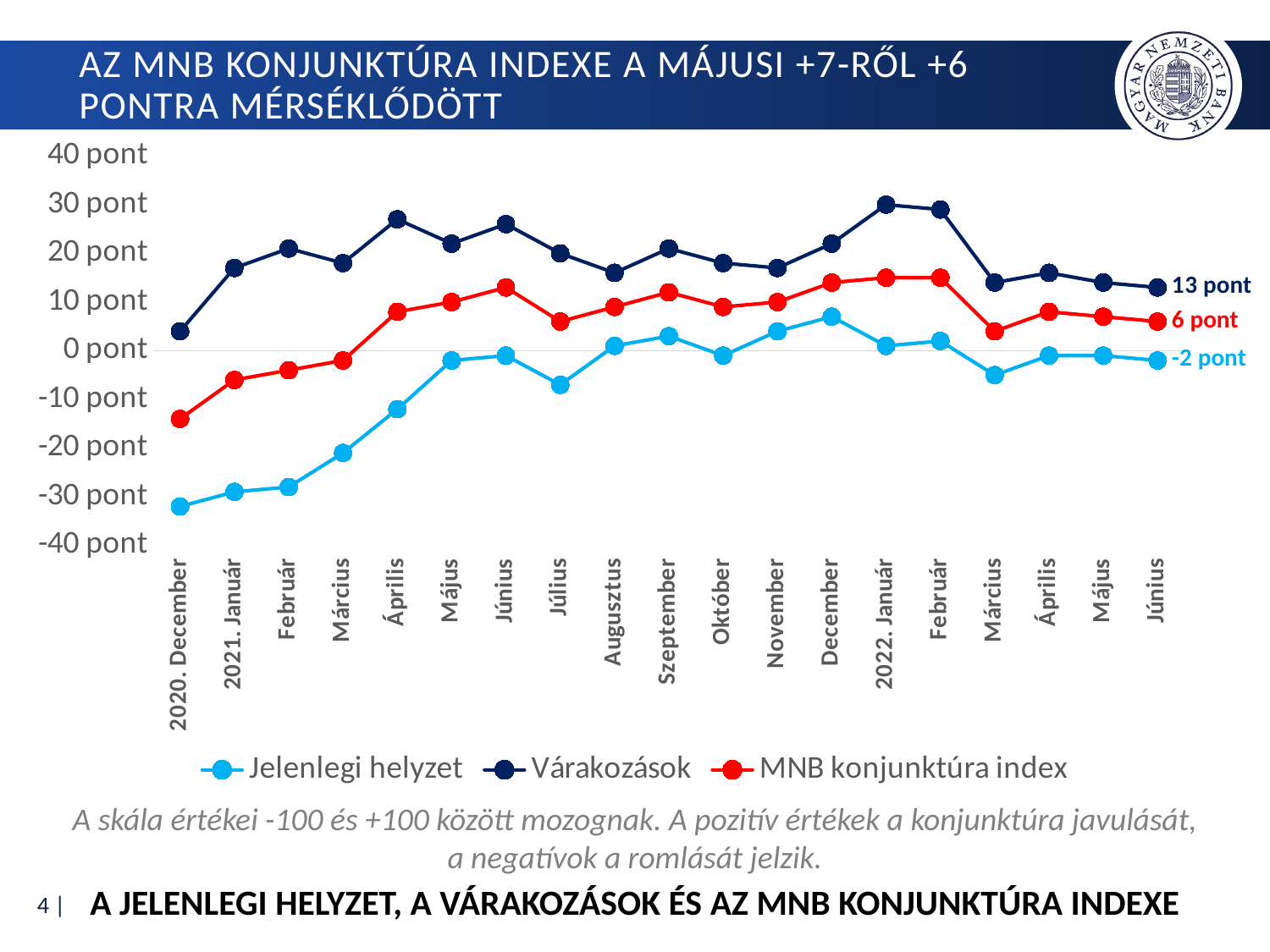
How many series does the legend list? 3 Is the value of Jelenlegi helyzet for 2020. December greater or less than -20 pont? less Which series has the highest value in 2022 Június? Várakozások What is the difference between the Várakozások and MNB konjunktúra index values in 2022 Június? 7 pont How many months are shown on the x axis? 19 What is the value of the Várakozások series for 2022 Június? 13 pont Is the value of Várakozások for 2022. Január greater or less than 20 pont? greater In 2020. December, which is higher: Várakozások or Jelenlegi helyzet? Várakozások Does the Jelenlegi helyzet series rise or fall from 2020. December to 2021 Június? rises What is the value of the Jelenlegi helyzet series for 2022 Június? -2 pont What kind of chart is shown on the slide? line chart What is the value of the MNB konjunktúra index for 2022 Június? 6 pont